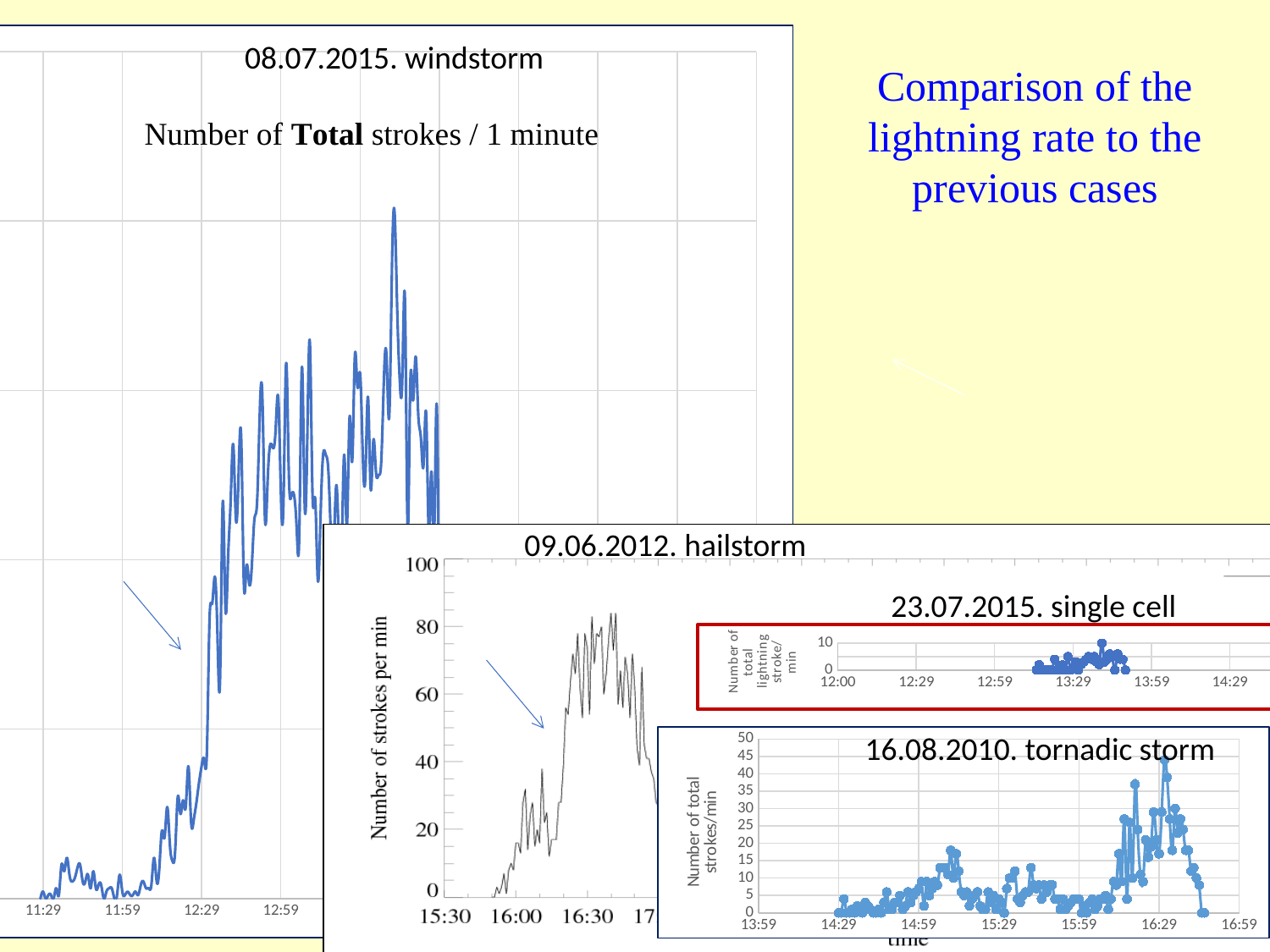
What is the maximum value shown on the y-axis of the "16.08.2010. tornadic storm" chart? 50 In the "23.07.2015. single cell" chart, are the plotted values greater or less than 10? less What kind of chart is the "09.06.2012. hailstorm" chart? line chart In the "09.06.2012. hailstorm" chart, is the peak value greater or less than 100? less In the "16.08.2010. tornadic storm" chart, is the highest value greater or less than 50? less In the "08.07.2015. windstorm" chart, do the values generally rise or fall between 11:59 and 12:29? rise In the "16.08.2010. tornadic storm" chart, is the value at 16:29 greater or less than the value at 14:29? greater What is the y-axis label of the "09.06.2012. hailstorm" chart? Number of strokes per min How many charts are shown on the slide? 4 What is the first time label on the x-axis of the "08.07.2015. windstorm" chart? 11:29